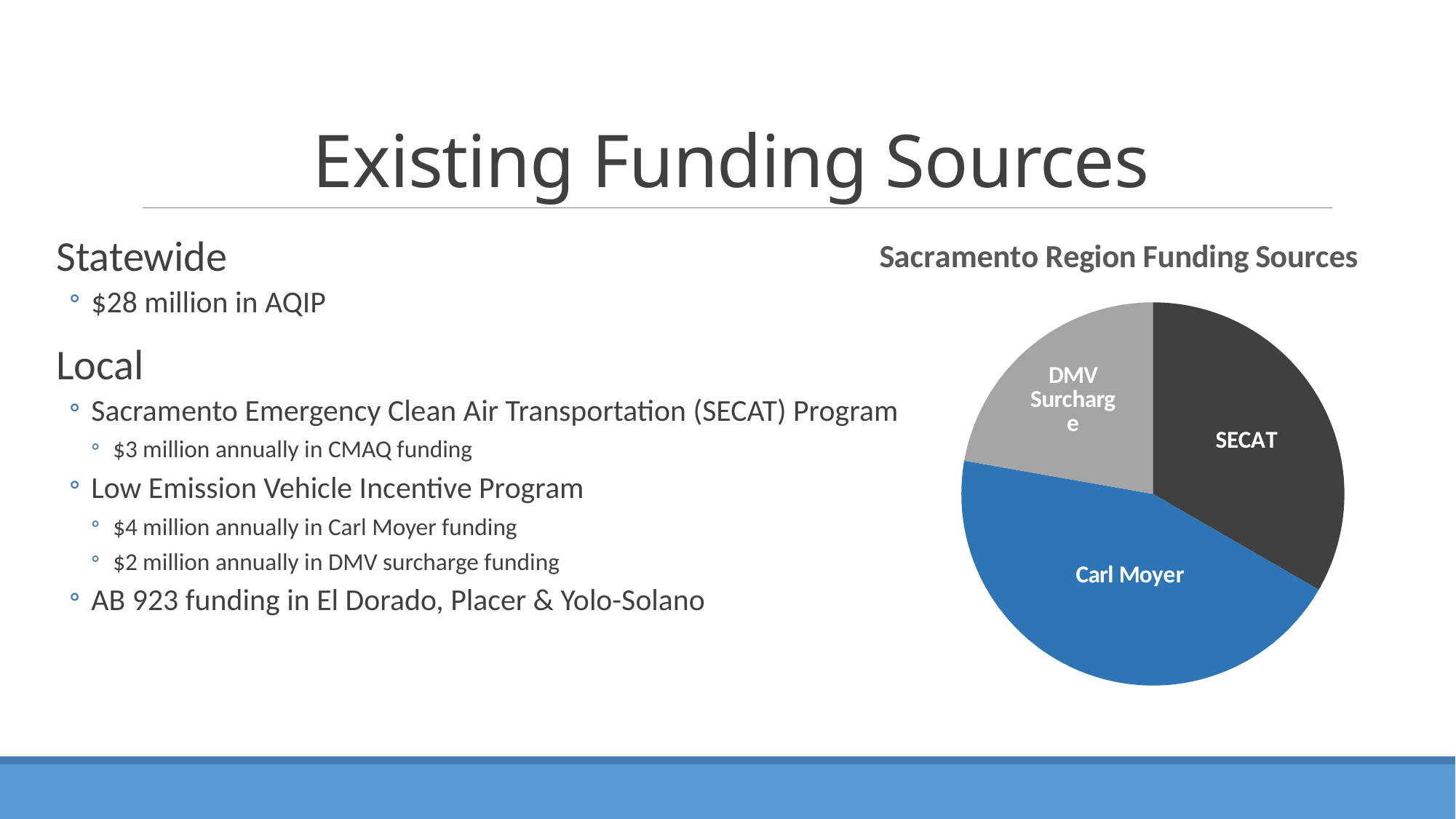
Which slice is larger in the pie chart, Carl Moyer or SECAT? Carl Moyer Which funding source has the largest slice of the pie chart? Carl Moyer Which slice is larger in the pie chart, SECAT or DMV Surcharge? SECAT How many slices does the pie chart have? 3 What is the title of the pie chart? Sacramento Region Funding Sources What kind of chart is shown on the slide? pie chart What colour is the Carl Moyer slice in the pie chart? blue Which funding source has the smallest slice of the pie chart? DMV Surcharge